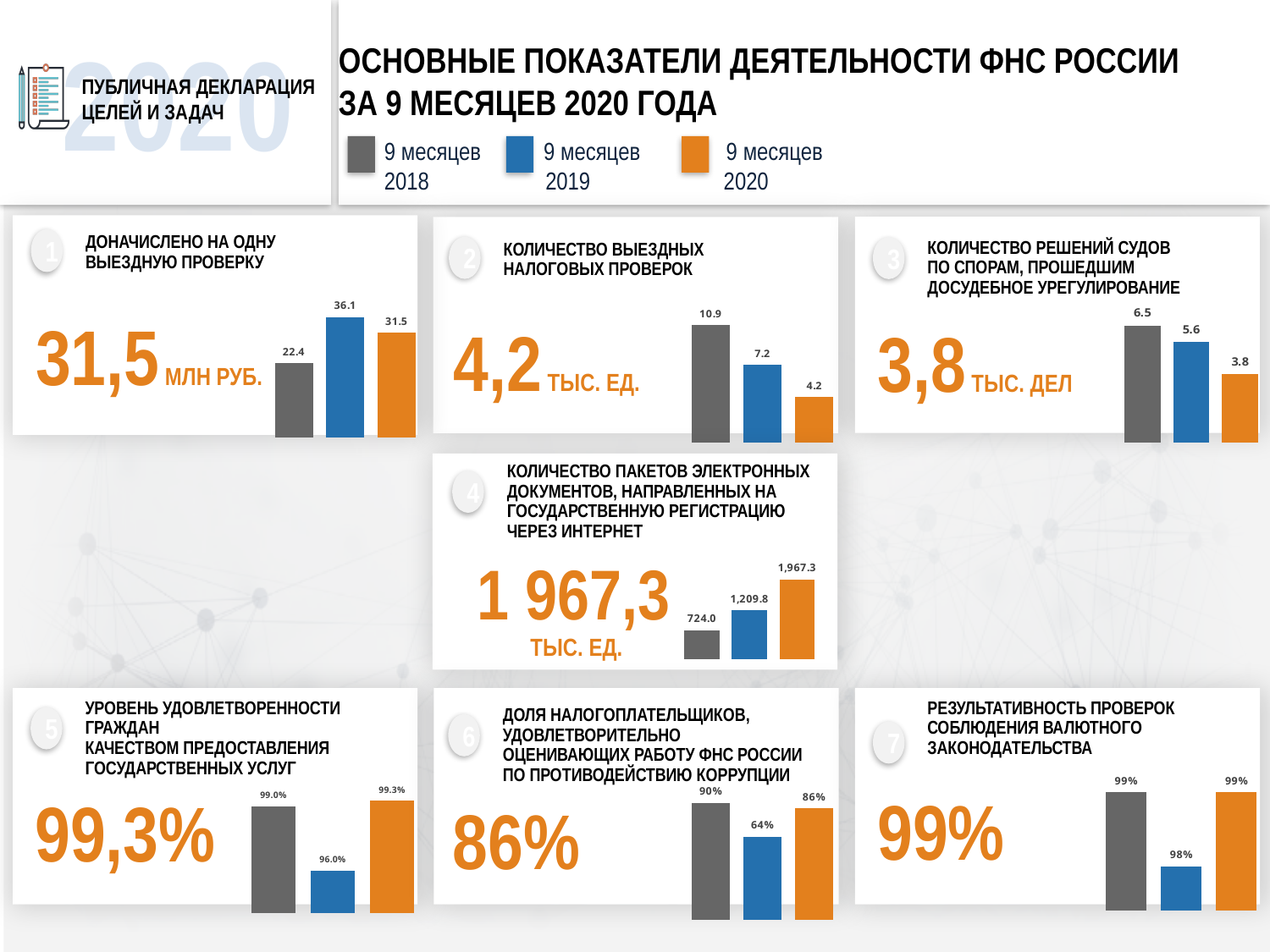
In chart 4 (Количество пакетов электронных документов), which period has the highest value? 9 месяцев 2020 In chart 2 (Количество выездных налоговых проверок), do the values rise or fall from 2018 to 2020? fall In chart 6 (Доля налогоплательщиков, удовлетворительно оценивающих работу ФНС), which is larger: the 2018 value or the 2020 value? 2018 (90%) How many series does the legend at the top of the slide list? 3 In chart 2 (Количество выездных налоговых проверок), what is the value for 9 месяцев 2018? 10.9 In chart 3 (Количество решений судов по спорам), what is the difference between the 2018 and 2020 values? 2.7 In chart 6 (Доля налогоплательщиков), what is the difference between the 2018 and 2019 values? 26% In chart 1 (Доначислено на одну выездную проверку), which period has the lowest value? 9 месяцев 2018 In chart 4 (Количество пакетов электронных документов), what is the value for 9 месяцев 2019? 1,209.8 In chart 7 (Результативность проверок соблюдения валютного законодательства), what is the value for 9 месяцев 2019? 98% In chart 1 (Доначислено на одну выездную проверку), what is the value for 9 месяцев 2019? 36.1 In chart 5 (Уровень удовлетворенности граждан), what is the value for 9 месяцев 2019? 96.0%